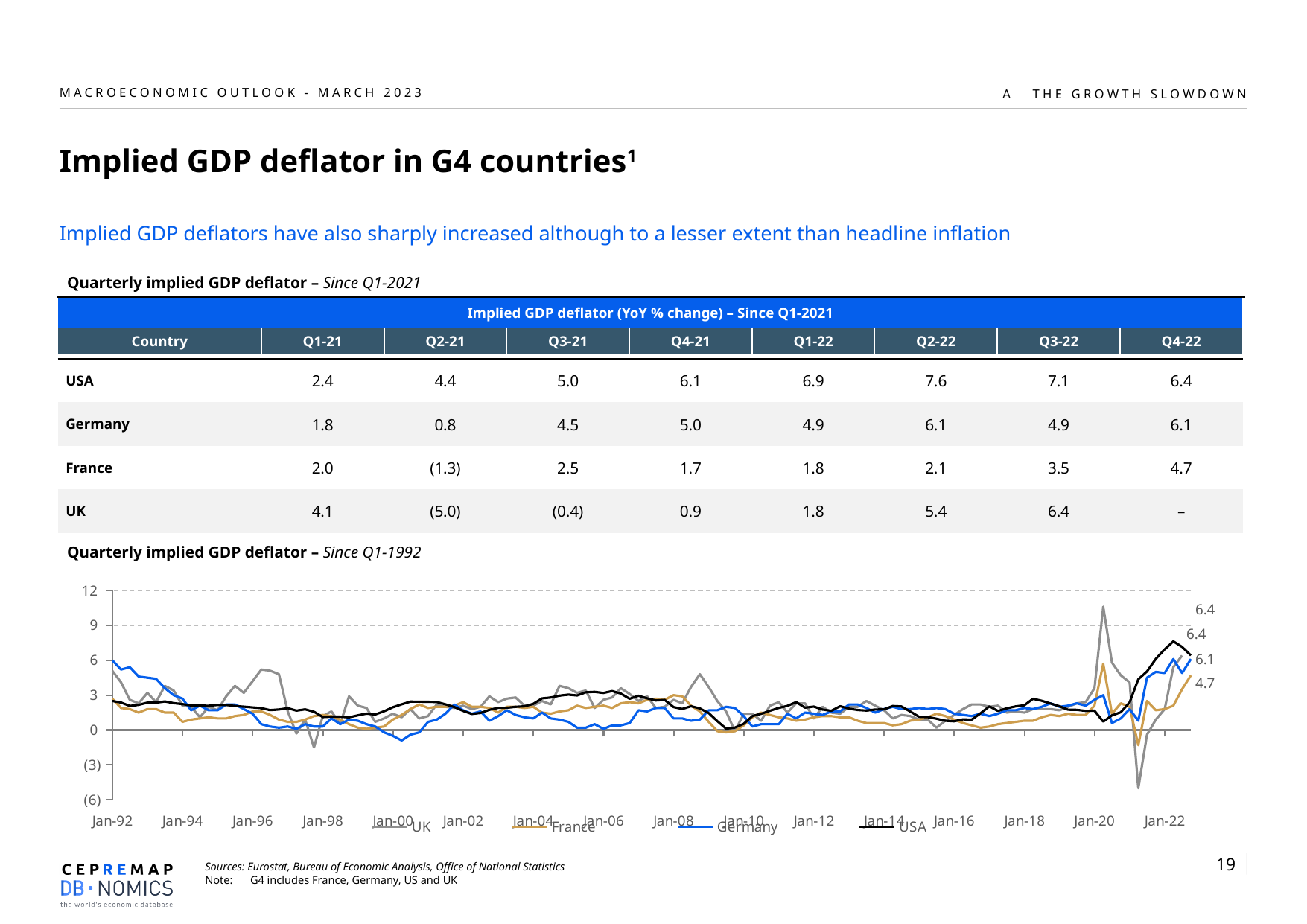
In the line chart, is the UK's lowest value around 2020 greater or less than (3)? less In the line chart, is the latest labelled value larger for Germany or for France? Germany In the line chart, does the USA line rise or fall between Jan-20 and Jan-22? rise In the line chart, is the UK's peak value around Jan-20 greater or less than 9? greater How many series does the legend of the line chart list? 4 In the line chart, what is the latest labelled value for Germany? 6.1 In the line chart, what colour is the line for the USA? black In the line chart, what is the difference between the latest labelled values for the USA and France? 1.7 What kind of chart is shown under 'Quarterly implied GDP deflator – Since Q1-1992'? line chart In the line chart, which country has the lowest latest labelled value? France In the line chart, what is the latest labelled value for the USA? 6.4 In the line chart, what is the latest labelled value for France? 4.7